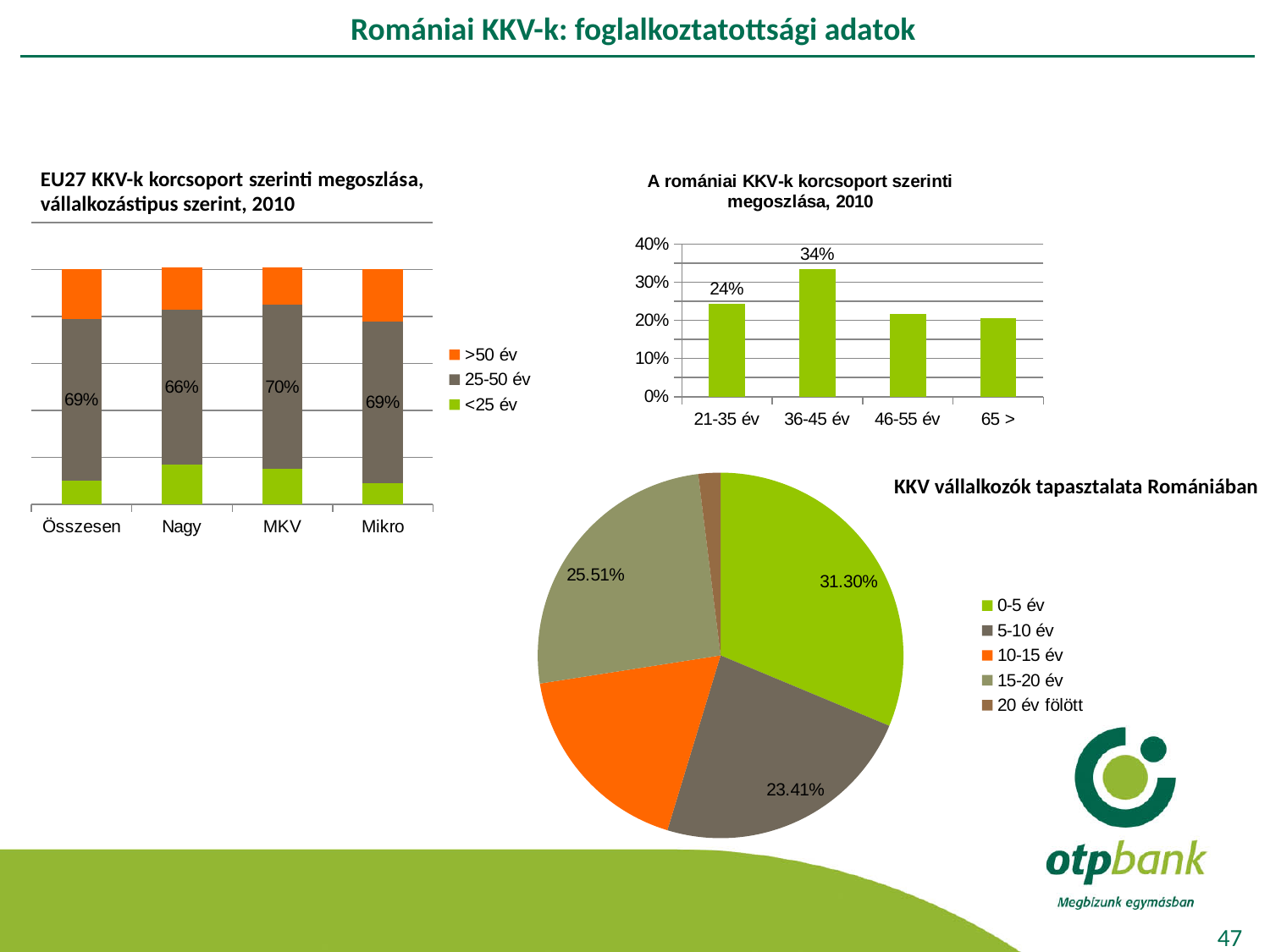
How many age-group categories are shown in the chart titled 'A romániai KKV-k korcsoport szerinti megoszlása, 2010'? 4 In the chart titled 'A romániai KKV-k korcsoport szerinti megoszlása, 2010', what is the value for 21-35 év? 24% In the pie chart titled 'KKV vállalkozók tapasztalata Romániában', what share does the 5-10 év slice have? 23.41% In the chart titled 'A romániai KKV-k korcsoport szerinti megoszlása, 2010', which age group has the highest value? 36-45 év In the chart titled 'EU27 KKV-k korcsoport szerinti megoszlása, vállalkozástipus szerint, 2010', what is the value of the 25-50 év segment for MKV? 70% In the chart titled 'EU27 KKV-k korcsoport szerinti megoszlása, vállalkozástipus szerint, 2010', what is the value of the 25-50 év segment for Nagy? 66% In the chart titled 'A romániai KKV-k korcsoport szerinti megoszlása, 2010', what is the value for 36-45 év? 34% In the chart titled 'A romániai KKV-k korcsoport szerinti megoszlása, 2010', is the value for 46-55 év greater or less than 30%? less In the chart titled 'A romániai KKV-k korcsoport szerinti megoszlása, 2010', what is the difference between the values for 36-45 év and 21-35 év? 10 percentage points What kind of chart is the one titled 'EU27 KKV-k korcsoport szerinti megoszlása, vállalkozástipus szerint, 2010'? Stacked bar chart In the pie chart titled 'KKV vállalkozók tapasztalata Romániában', what share does the 0-5 év slice have? 31.30% How many series does the legend list in the chart titled 'EU27 KKV-k korcsoport szerinti megoszlása, vállalkozástipus szerint, 2010'? 3